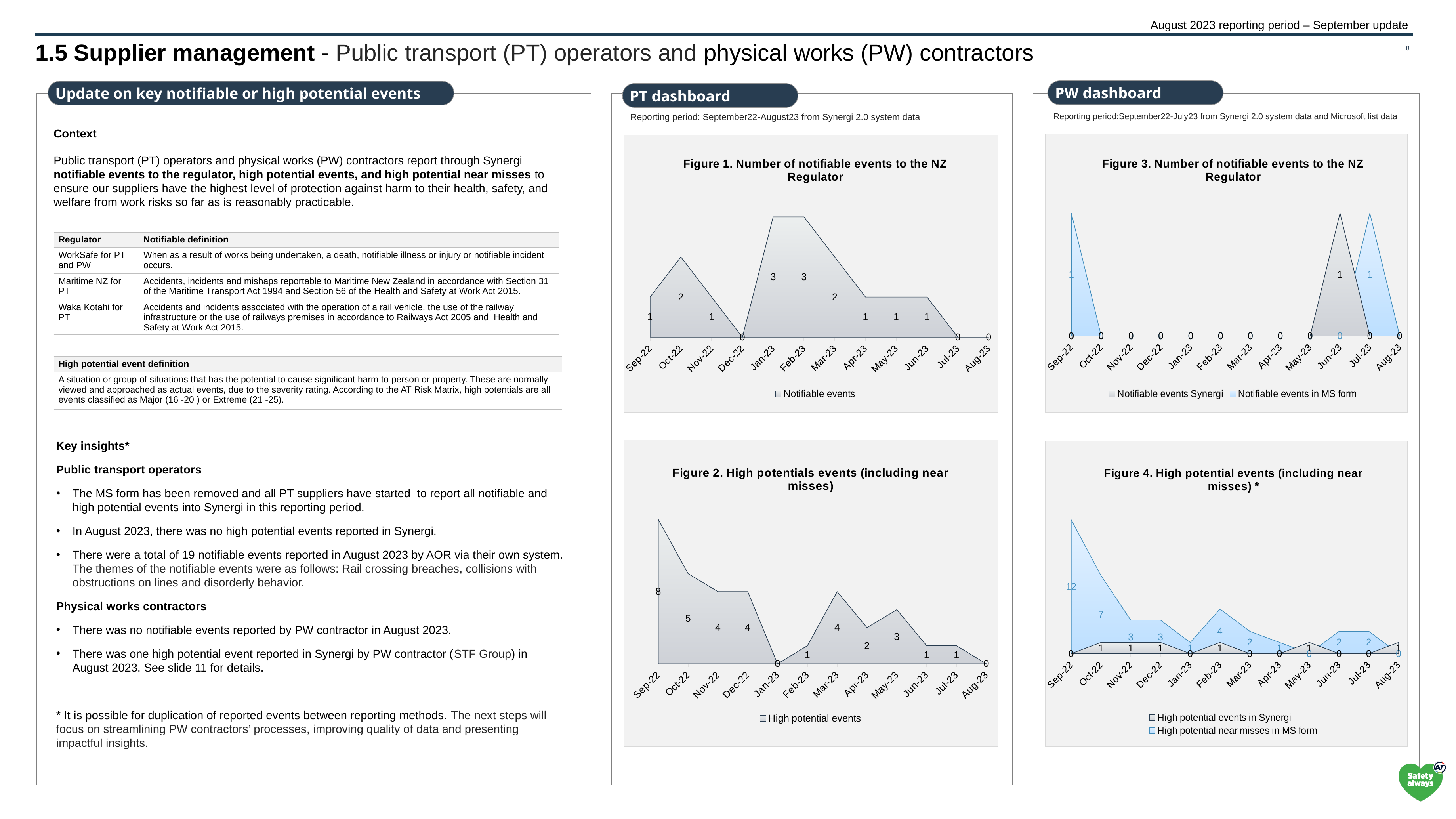
In Figure 3 (PW dashboard), how many series does the legend list? 2 In Figure 4 (High potential events, PW dashboard), what is the value of High potential near misses in MS form for Sep-22? 12 In Figure 2 (PT dashboard), what is the value for Aug-23? 0 In Figure 3 (PW dashboard), what is the value of Notifiable events Synergi for Jun-23? 1 In Figure 1 (PT dashboard), which month has the highest number of notifiable events? Jan-23 and Feb-23 (3 each) In Figure 1 (PT dashboard), how many months are plotted on the x axis? 12 In Figure 4 (PW dashboard), what is the difference between High potential near misses in MS form for Sep-22 and Oct-22? 5 In Figure 2 (High potentials events, PT dashboard), what is the value for Sep-22? 8 What kind of chart is Figure 2 on the PT dashboard? Area chart In Figure 1 (Number of notifiable events to the NZ Regulator, PT dashboard), what is the value for Oct-22? 2 In Figure 2 (PT dashboard), what is the difference between the values for Sep-22 and Oct-22? 3 In Figure 2 (PT dashboard), which is larger, the value for Mar-23 or the value for Apr-23? Mar-23